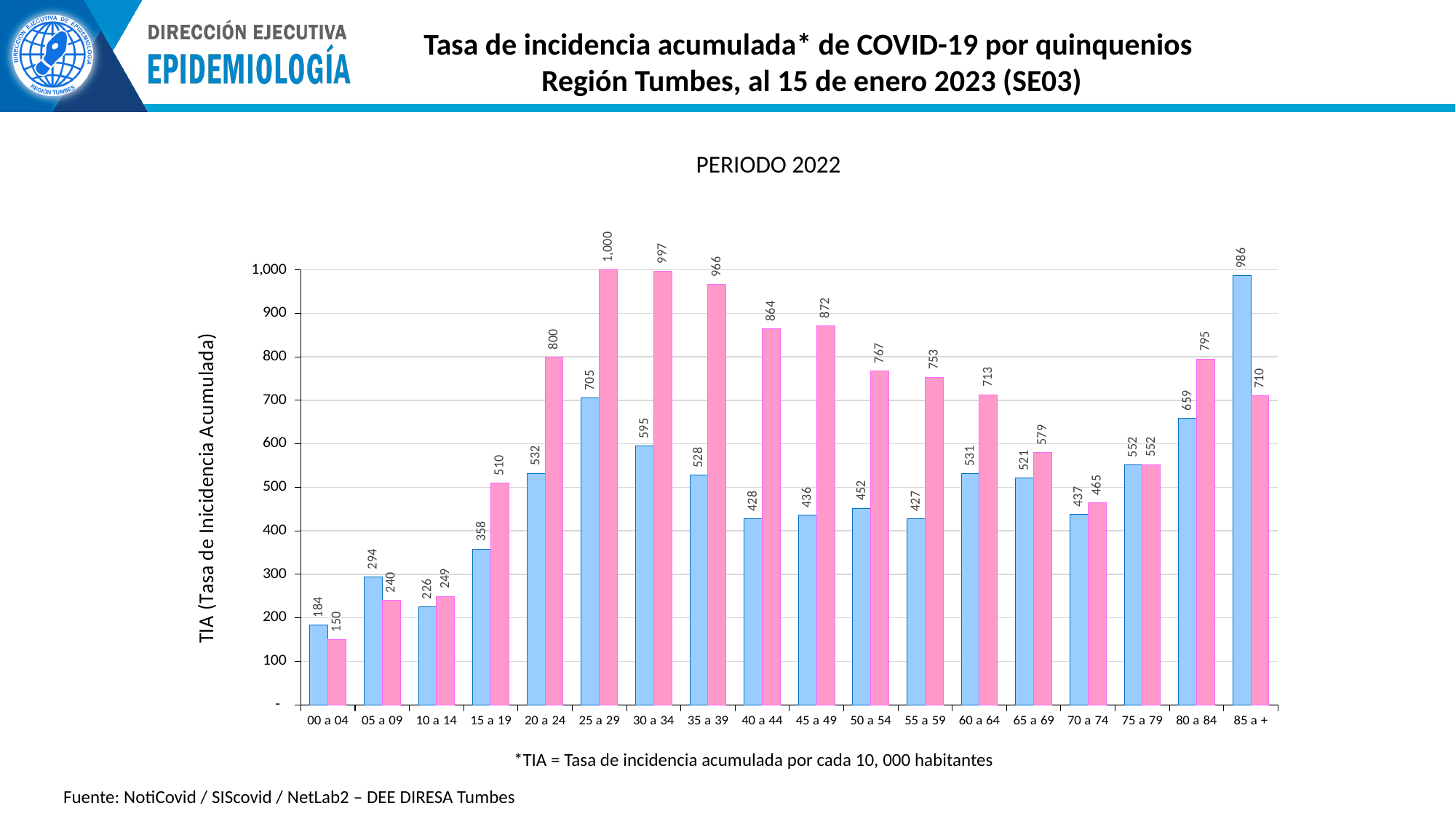
Which age group has the highest blue bar? 85 a + What is the value of the pink bar for the 75 a 79 age group? 552 For the 85 a + age group, how much larger is the blue bar than the pink bar? 276 What is the value of the blue bar for the 25 a 29 age group? 705 Which age group has the lowest blue bar? 00 a 04 Which age group has the lowest pink bar? 00 a 04 Which age group has the highest pink bar? 25 a 29 How many age groups are shown on the x axis? 18 What is the value of the pink bar for the 45 a 49 age group? 872 For the 20 a 24 age group, how much larger is the pink bar than the blue bar? 268 For the 05 a 09 age group, which bar is larger, the blue or the pink? blue What kind of chart is shown on the slide? bar chart